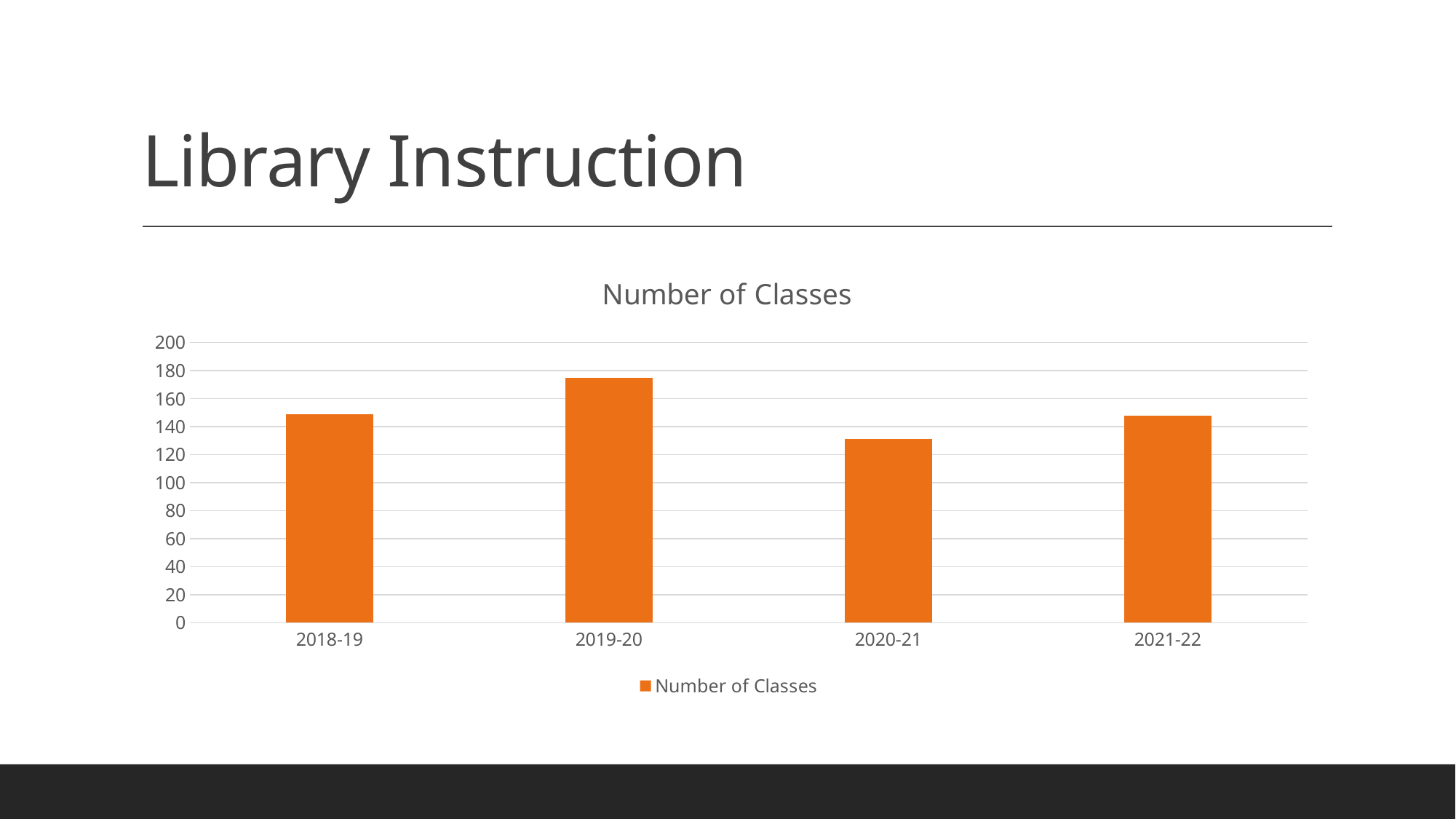
What type of chart is shown on the slide? bar chart Is the value for 2020-21 greater or less than 120? greater Which year has the lowest number of classes? 2020-21 Which is larger, the value for 2019-20 or the value for 2020-21? 2019-20 Is the value for 2021-22 greater or less than 160? less How many series does the legend list? 1 Is the value for 2019-20 greater or less than 160? greater How many categories are shown on the x axis? 4 Does the number of classes rise or fall from 2019-20 to 2020-21? fall Which year has the highest number of classes? 2019-20 What is the title of the chart? Number of Classes